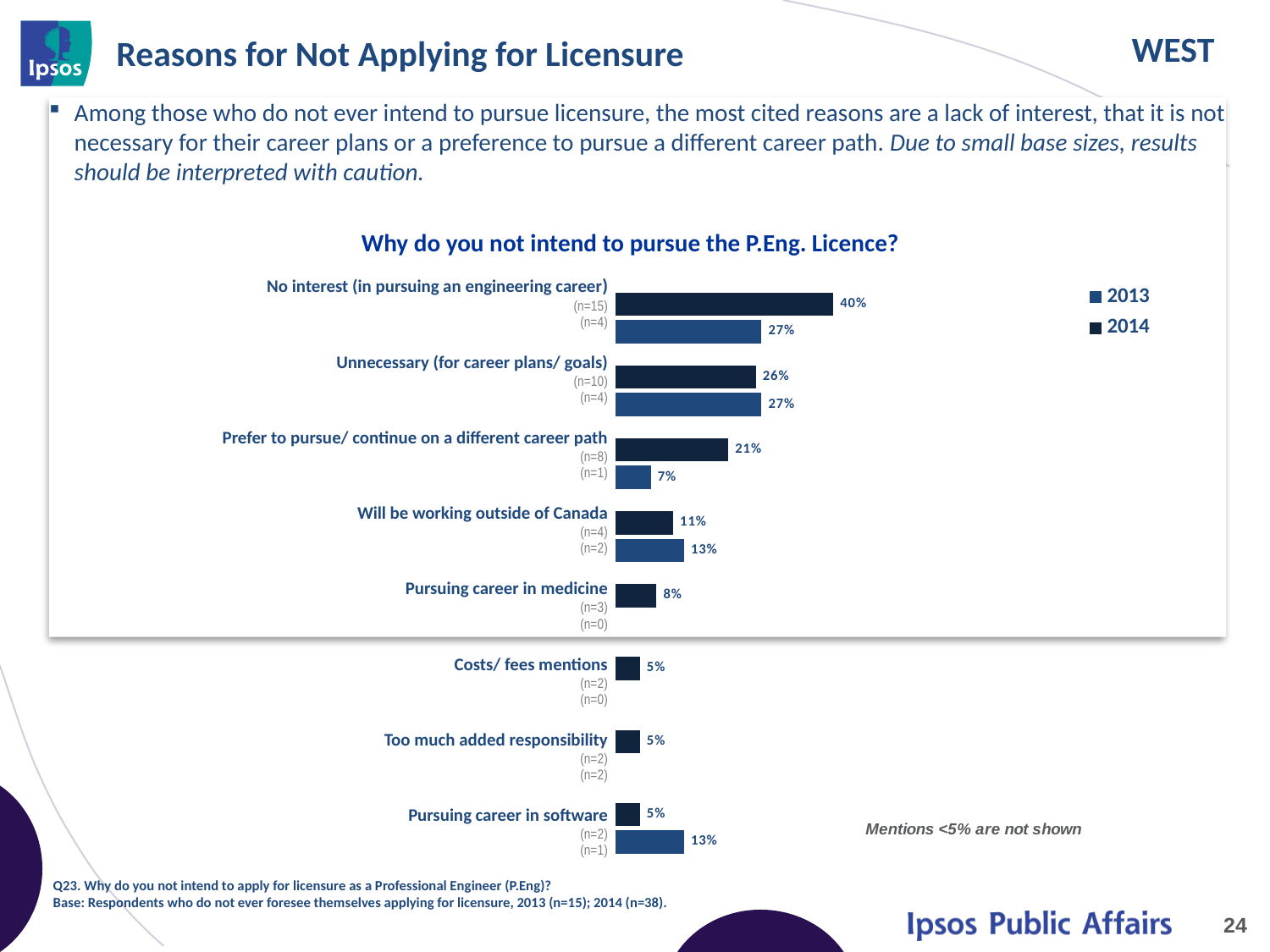
What is the 2013 value for 'Unnecessary (for career plans/ goals)'? 27% For 'Prefer to pursue/ continue on a different career path', which year has the larger value? 2014 How many series does the legend of the chart list? 2 What is the title of the chart? Why do you not intend to pursue the P.Eng. Licence? What is the 2014 value for 'No interest (in pursuing an engineering career)'? 40% What is the difference between the 2014 and 2013 values for 'No interest (in pursuing an engineering career)'? 13 percentage points What is the 2014 value for 'Pursuing career in medicine'? 8% Which reason has the highest value in the chart? No interest (in pursuing an engineering career) What is the 2013 value for 'Will be working outside of Canada'? 13% What kind of chart is used to show the reasons for not intending to pursue the P.Eng. licence? Bar chart How many reason categories are shown in the chart? 8 What is the difference between the 2013 and 2014 values for 'Pursuing career in software'? 8 percentage points